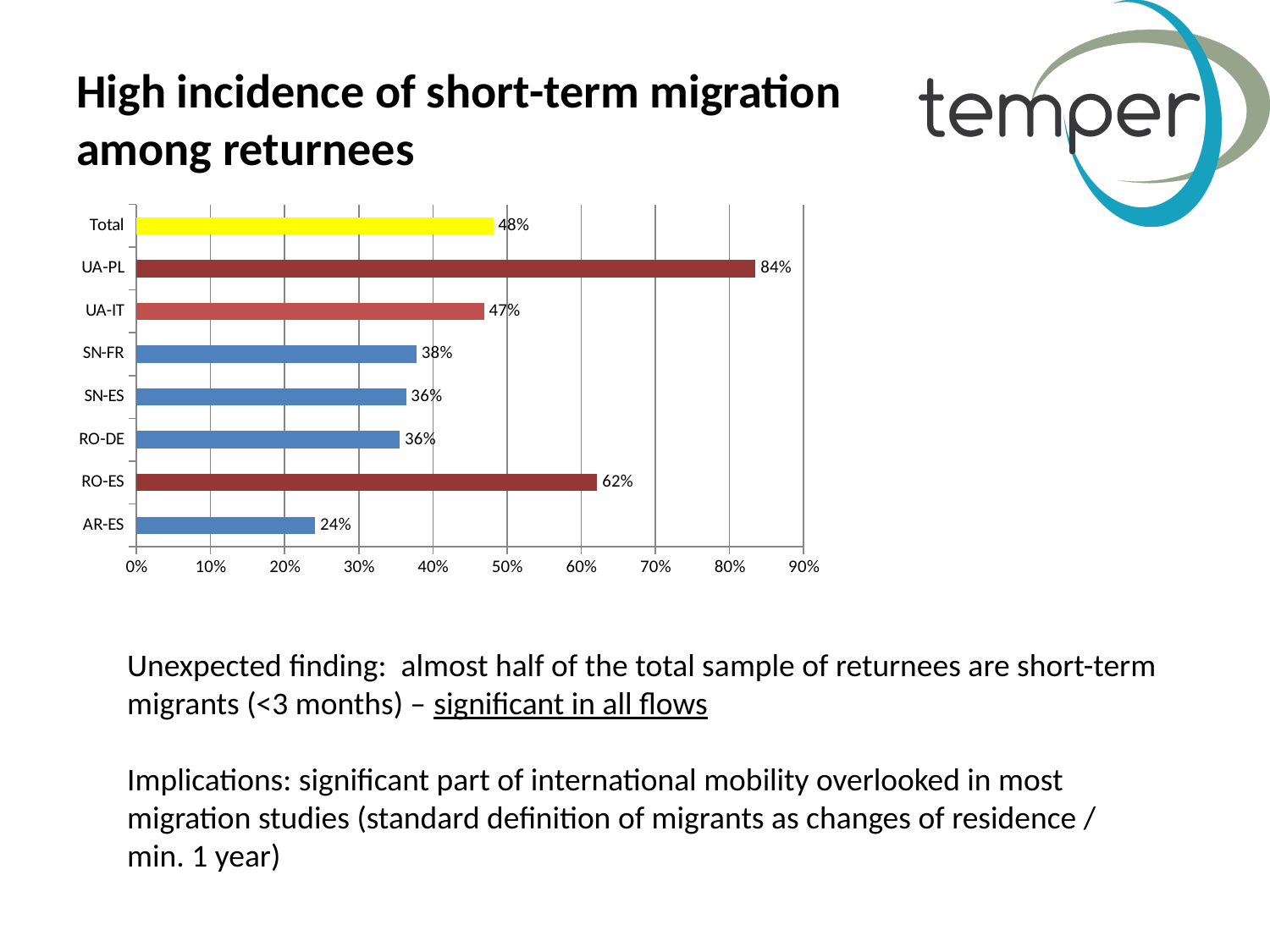
Which category has the highest value? UA-PL What colour is the Total bar? yellow What is the value for UA-PL? 84% What kind of chart is shown on the slide? bar chart What is the value for AR-ES? 24% Is the value for UA-IT greater or less than 40%? greater Which category has the lowest value? AR-ES What is the difference between the values for UA-PL and UA-IT? 37% What is the value for the Total bar? 48% What is the value for RO-ES? 62% How many categories are shown on the chart? 8 Which is larger, the value for RO-ES or the value for SN-FR? RO-ES